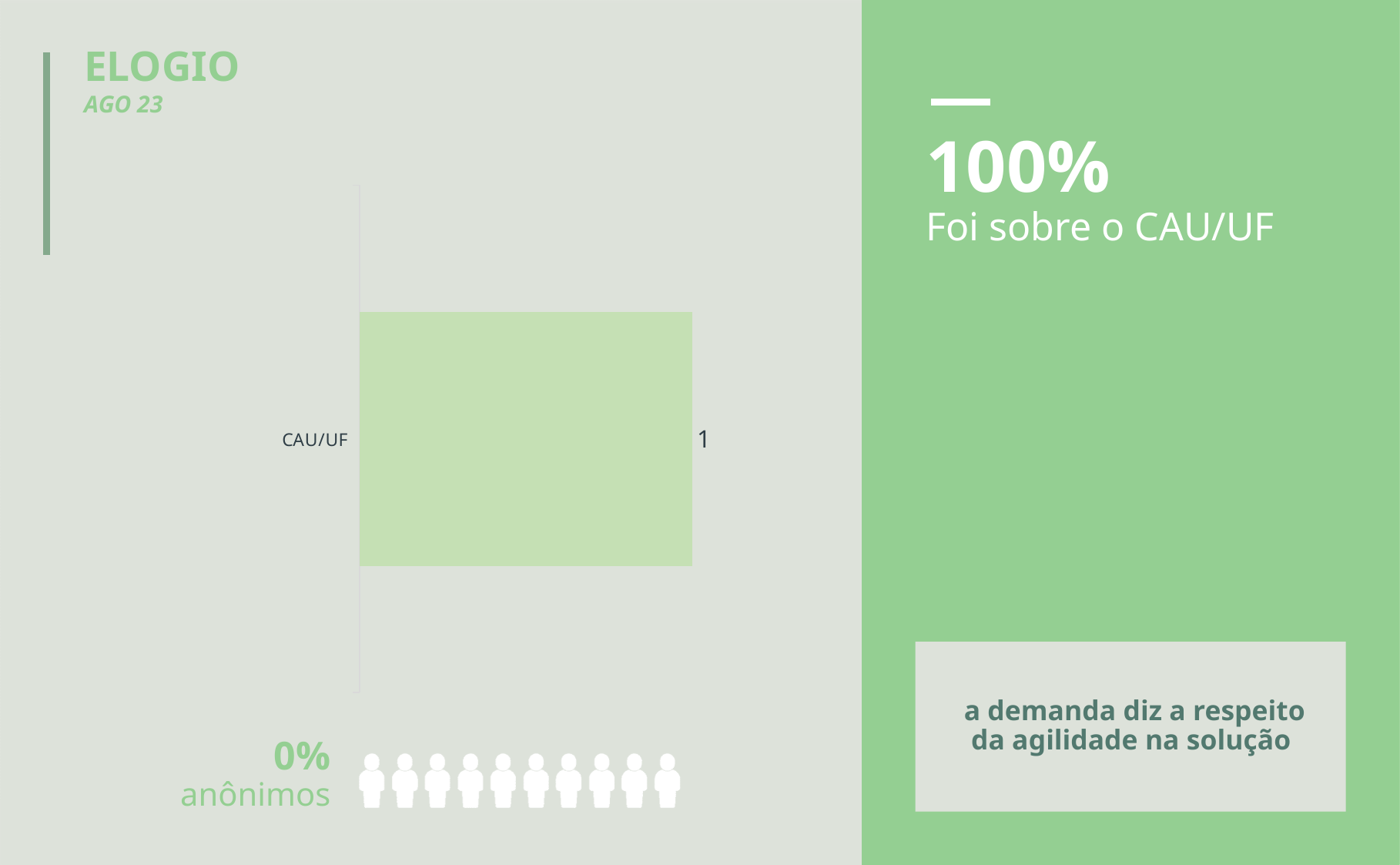
What is the title of the slide containing the bar chart? ELOGIO Which category is shown in the bar chart? CAU/UF How many categories does the bar chart show? 1 What kind of chart is shown on the slide? bar chart Is the value for CAU/UF greater or less than 0? greater What is the value for CAU/UF in the bar chart? 1